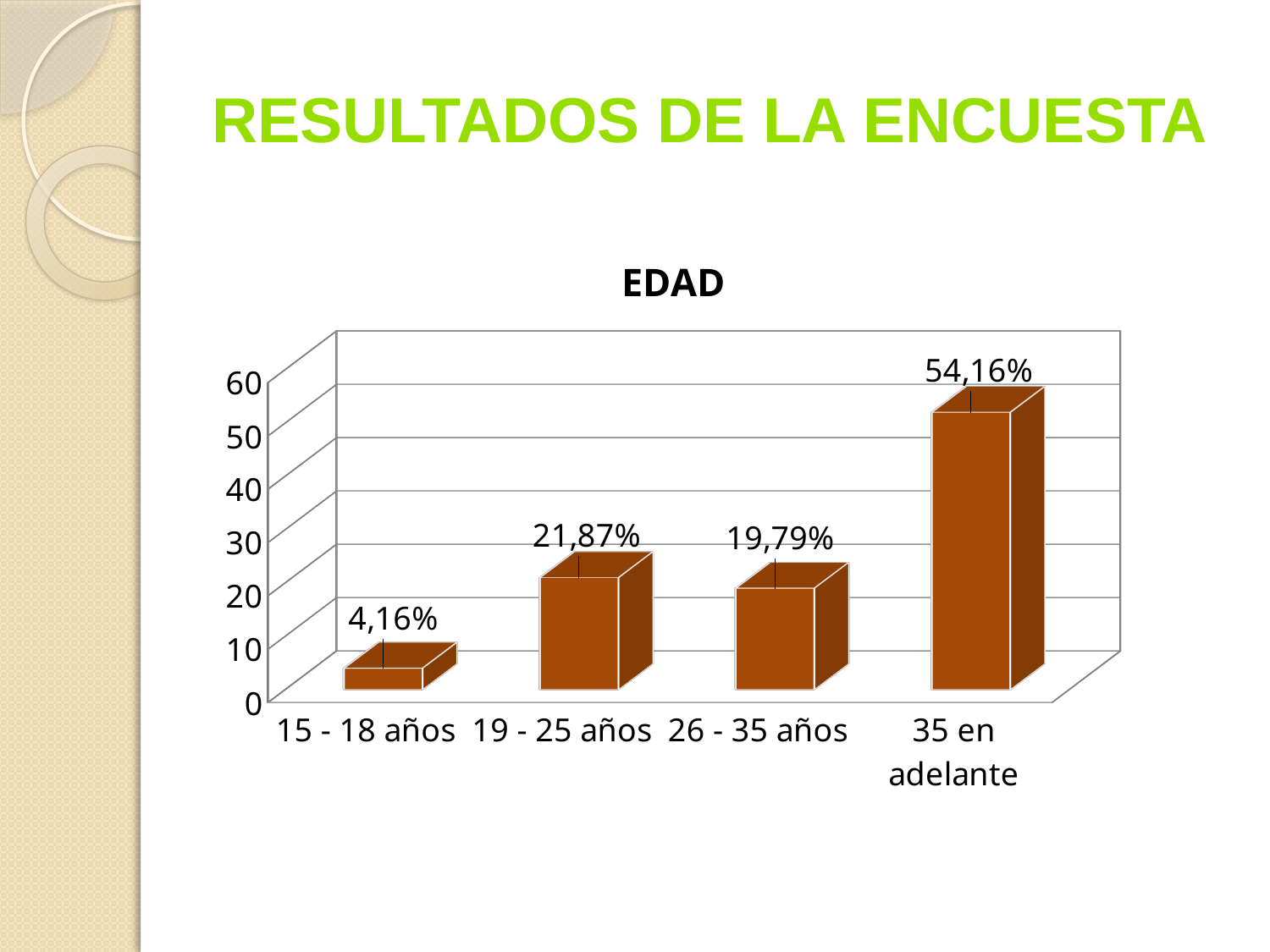
How many age categories are shown in the chart? 4 What is the value for the 19 - 25 años category? 21,87% What is the value for the 35 en adelante category? 54,16% What is the title of the chart? EDAD Which age category has the lowest value? 15 - 18 años Which is larger, the value for 19 - 25 años or the value for 26 - 35 años? 19 - 25 años What is the difference between the values for 35 en adelante and 15 - 18 años? 50 percentage points What is the difference between the values for 19 - 25 años and 26 - 35 años? 2,08 percentage points Which age category has the highest value? 35 en adelante What is the value for the 15 - 18 años category? 4,16% What is the value for the 26 - 35 años category? 19,79% What kind of chart is shown on the slide? Bar chart